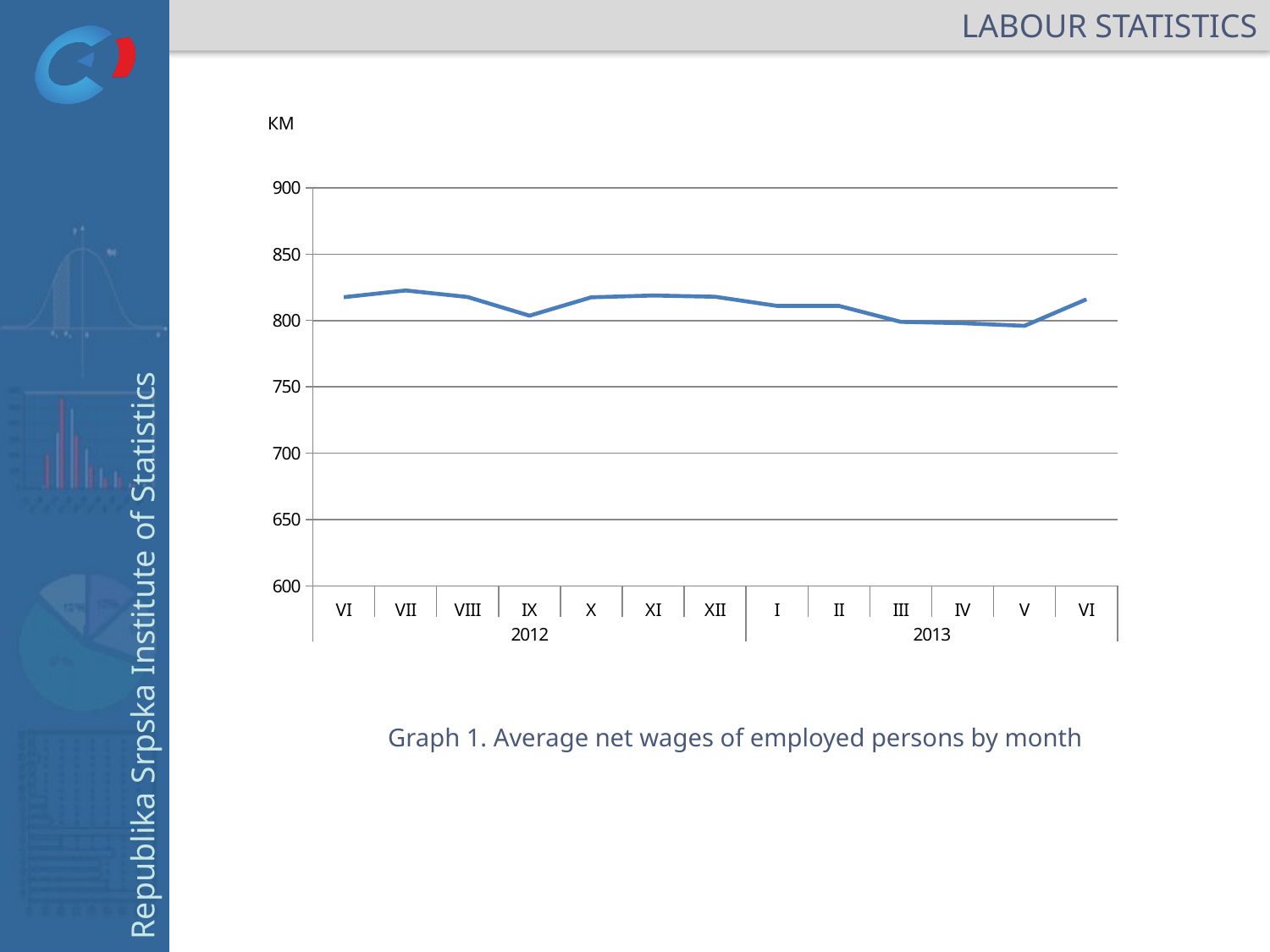
Which is larger, the value for month IX of 2012 or the value for month X of 2012? X of 2012 What is the title of the graph on the slide? Graph 1. Average net wages of employed persons by month Do the values rise or fall from month XII of 2012 to month V of 2013? fall What kind of chart is shown on the slide? line chart Which is larger, the value for month VII of 2012 or the value for month V of 2013? VII of 2012 Is the value for month I of 2013 greater or less than 850? less Is the value for month V of 2013 greater or less than 750? greater Do the values rise or fall from month V of 2013 to month VI of 2013? rise Is the value for month VII of 2012 greater or less than 800? greater How many monthly data points are plotted on the chart? 13 What unit is shown on the vertical axis of the chart? KM